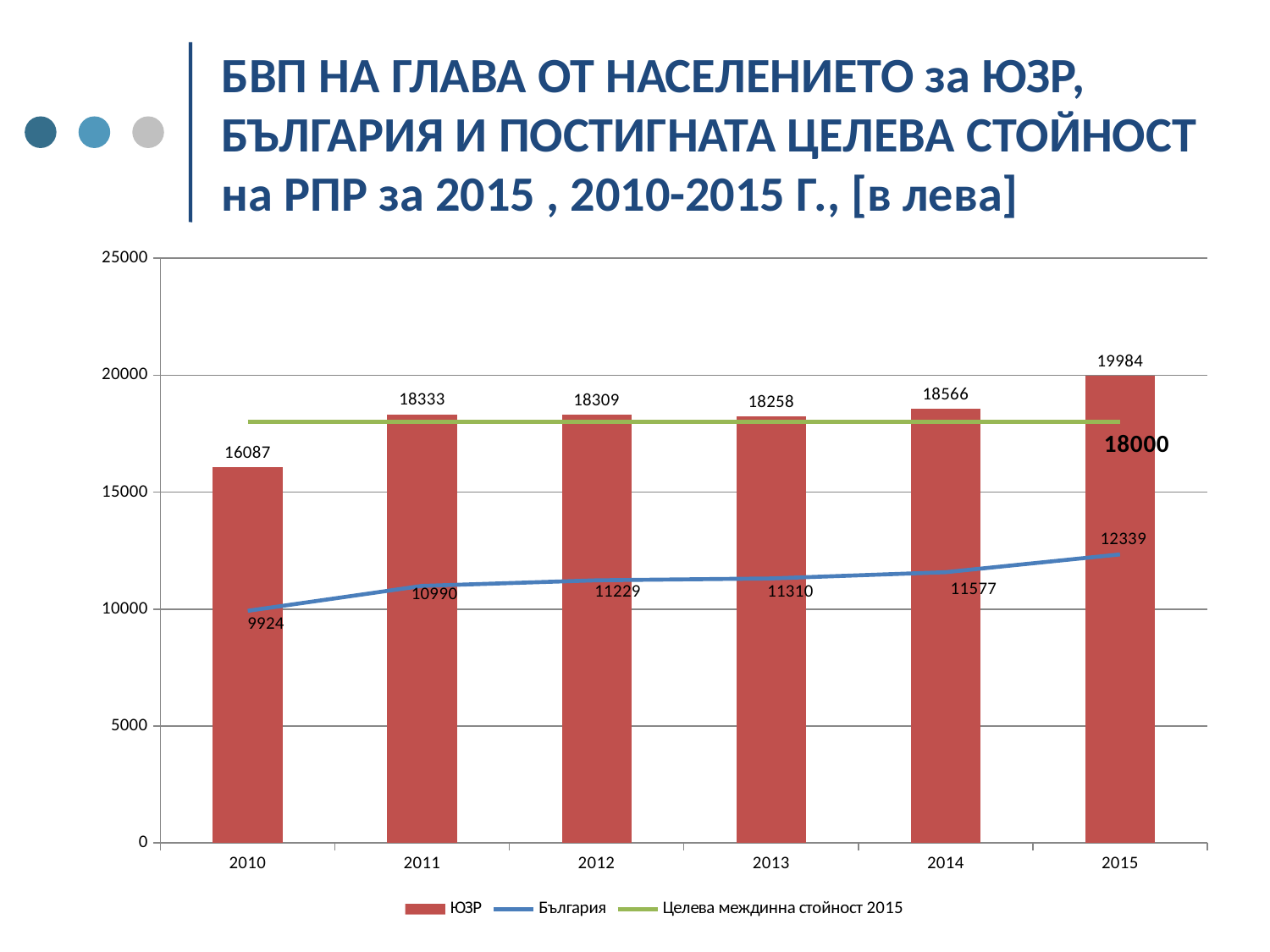
Is the ЮЗР value for 2010 greater or less than 15000? greater What is the value for България in 2010? 9924 What colour are the ЮЗР bars? red What is the value of the Целева междинна стойност 2015 line? 18000 How many years are shown on the x axis? 6 In which year is the ЮЗР value highest? 2015 Which is larger in 2013: the ЮЗР value or the България value? ЮЗР Does the България series rise or fall from 2010 to 2015? rise In which year is the ЮЗР value lowest? 2010 How many series does the legend list? 3 What is the value for ЮЗР in 2015? 19984 What is the difference between the ЮЗР value and the България value in 2015? 7645